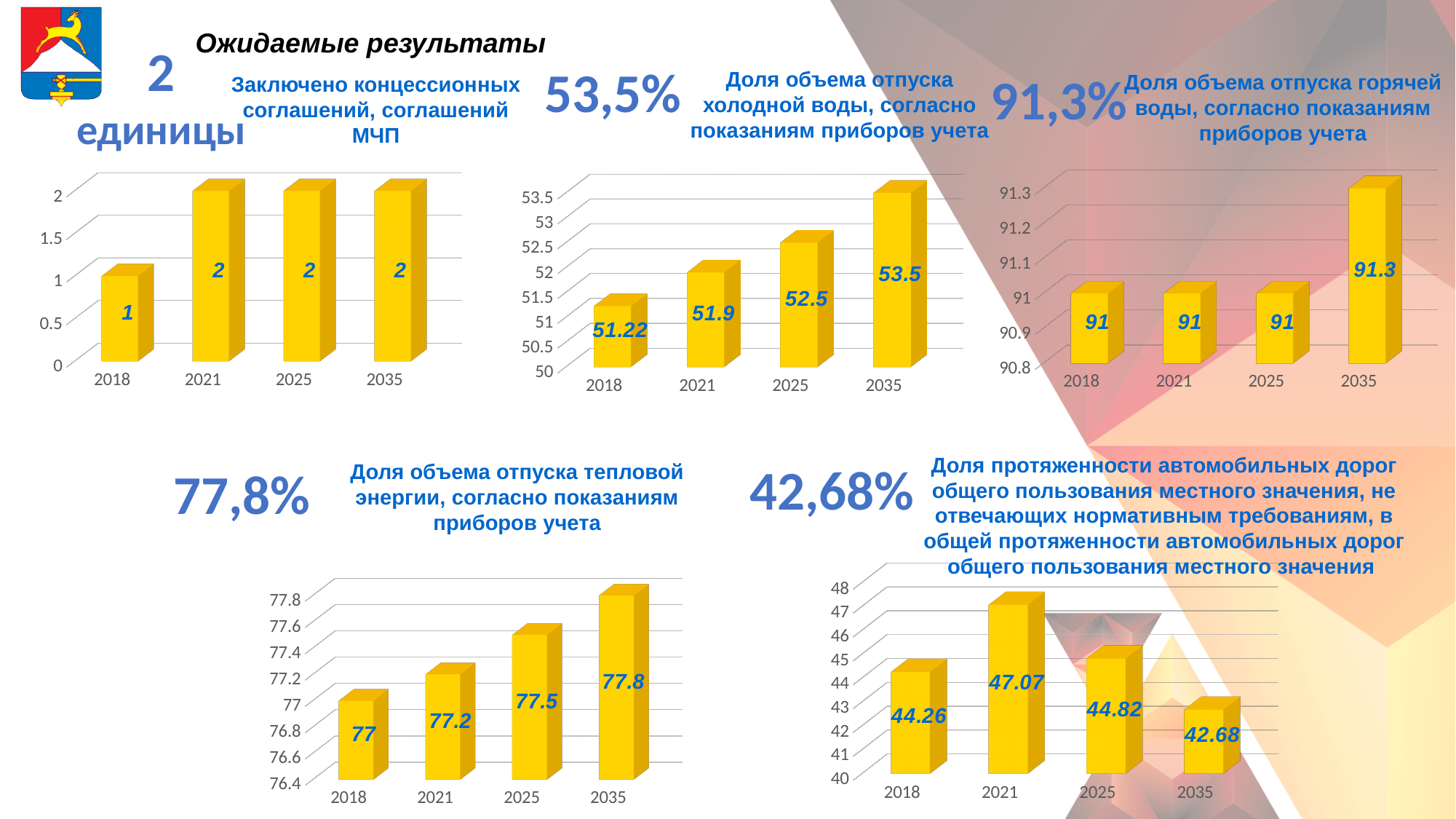
In the bottom-right chart (Доля протяженности автомобильных дорог), which is larger: the value for 2018 or the value for 2025? 2025 In the bottom-right chart (Доля протяженности автомобильных дорог), which year has the highest value? 2021 In the chart titled 'Доля объема отпуска холодной воды', what is the difference between the 2035 value and the 2018 value? 2.28 What type of chart is the top-right chart (Доля объема отпуска горячей воды)? bar chart In the top-left chart (Заключено концессионных соглашений, соглашений МЧП), what is the value for 2018? 1 In the chart titled 'Доля объема отпуска холодной воды, согласно показаниям приборов учета', what is the value for 2025? 52.5 In the bottom-left chart (Доля объема отпуска тепловой энергии), do the values rise or fall from 2018 to 2035? rise How many years (categories) are shown on the x axis of the top-middle chart (Доля объема отпуска холодной воды)? 4 In the bottom-left chart (Доля объема отпуска тепловой энергии), what is the value for 2021? 77.2 In the bottom-right chart (Доля протяженности автомобильных дорог), what is the difference between the 2021 value and the 2035 value? 4.39 In the chart titled 'Доля объема отпуска горячей воды, согласно показаниям приборов учета', what is the value for 2035? 91.3 In the bottom-right chart (Доля протяженности автомобильных дорог), which year has the lowest value? 2035